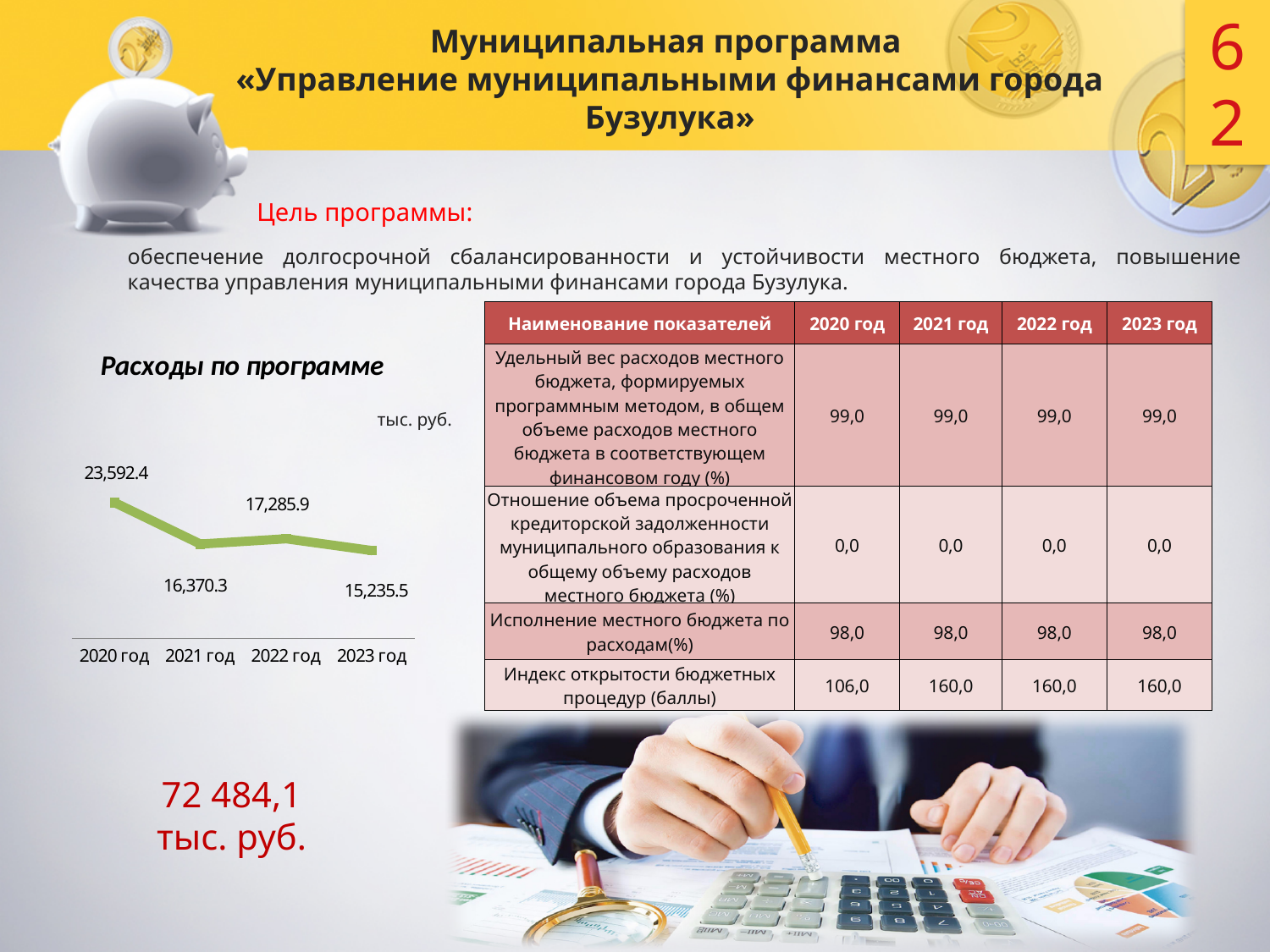
In the chart 'Расходы по программе', which is larger: the value for 2021 год or 2022 год? 2022 год What is the value for 2023 год in the chart 'Расходы по программе'? 15,235.5 In the chart 'Расходы по программе', what is the difference between the values for 2022 год and 2023 год? 2,050.4 What type of chart is 'Расходы по программе'? line chart Which year has the highest value in the chart 'Расходы по программе'? 2020 год What is the value for 2021 год in the chart 'Расходы по программе'? 16,370.3 How many years are plotted in the chart 'Расходы по программе'? 4 What is the value for 2022 год in the chart 'Расходы по программе'? 17,285.9 In the chart 'Расходы по программе', what is the difference between the values for 2020 год and 2021 год? 7,222.1 Which year has the lowest value in the chart 'Расходы по программе'? 2023 год What unit is indicated for the values in the chart 'Расходы по программе'? тыс. руб. What is the value for 2020 год in the chart 'Расходы по программе'? 23,592.4